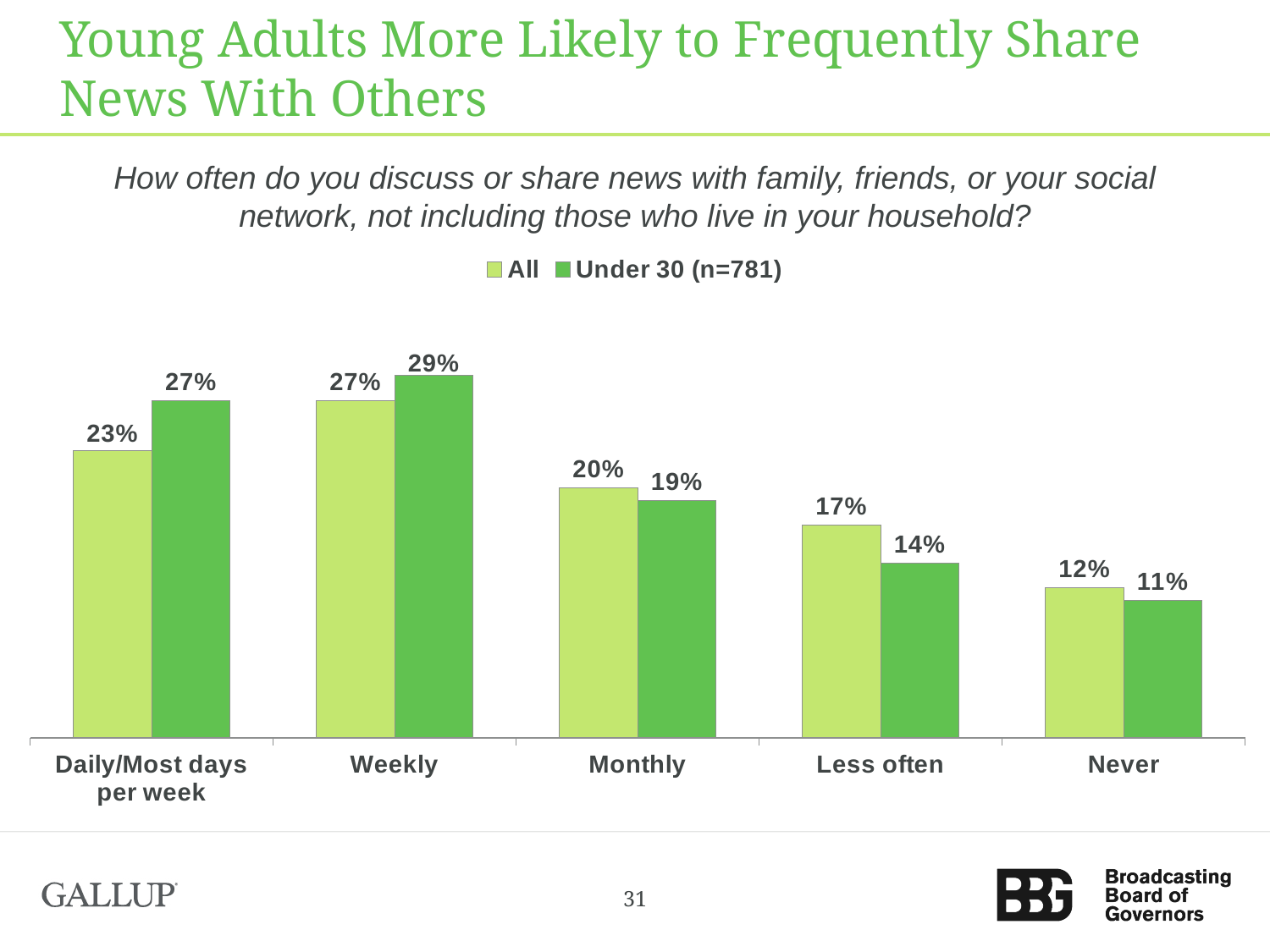
Which category has the highest value for the Under 30 (n=781) series? Weekly Which category has the lowest value for the All series? Never What is the sample size shown in the legend for the Under 30 series? n=781 What percentage of all respondents say they share news Weekly? 27% What kind of chart is shown on the slide? Bar chart What is the difference between the Under 30 and All values for Daily/Most days per week? 4 percentage points What is the difference between the All and Under 30 values for Less often? 3 percentage points How many categories are shown on the x axis? 5 For the Monthly category, which series has the larger value, All or Under 30 (n=781)? All What percentage of respondents under 30 say they share news Daily/Most days per week? 27% How many series does the legend list? 2 What is the value for Under 30 (n=781) in the Never category? 11%